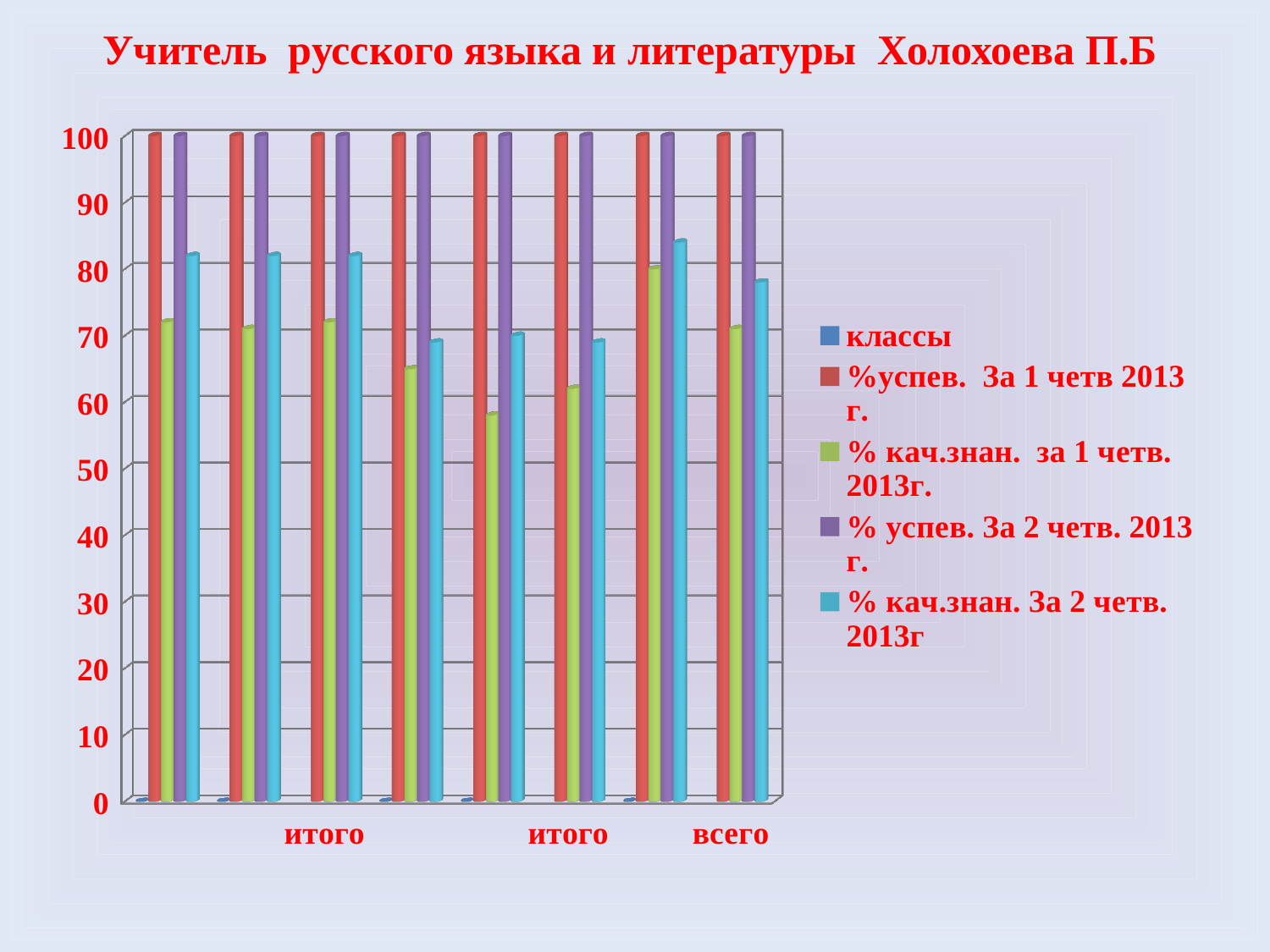
For the "всего" category, which is larger: "% кач.знан. за 1 четв. 2013г." or "% кач.знан. За 2 четв. 2013г"? % кач.знан. За 2 четв. 2013г What is the value of "%успев. За 1 четв 2013 г." for the "всего" category? 100 How many series does the legend list? 5 What is the value of "% успев. За 2 четв. 2013 г." for the "всего" category? 100 What is the title of the slide above the chart? Учитель русского языка и литературы Холохоева П.Б What is the highest value shown on the vertical axis? 100 Is the value of "% кач.знан. За 2 четв. 2013г" for the "всего" category greater or less than 70? greater How many groups of bars are plotted along the x axis? 8 Is the value of "% кач.знан. за 1 четв. 2013г." for the "всего" category greater or less than 90? less What kind of chart is shown on the slide? bar chart Which legend entry is shown in green? % кач.знан. за 1 четв. 2013г. For the "всего" category, which is larger: "%успев. За 1 четв 2013 г." or "% кач.знан. за 1 четв. 2013г."? %успев. За 1 четв 2013 г.